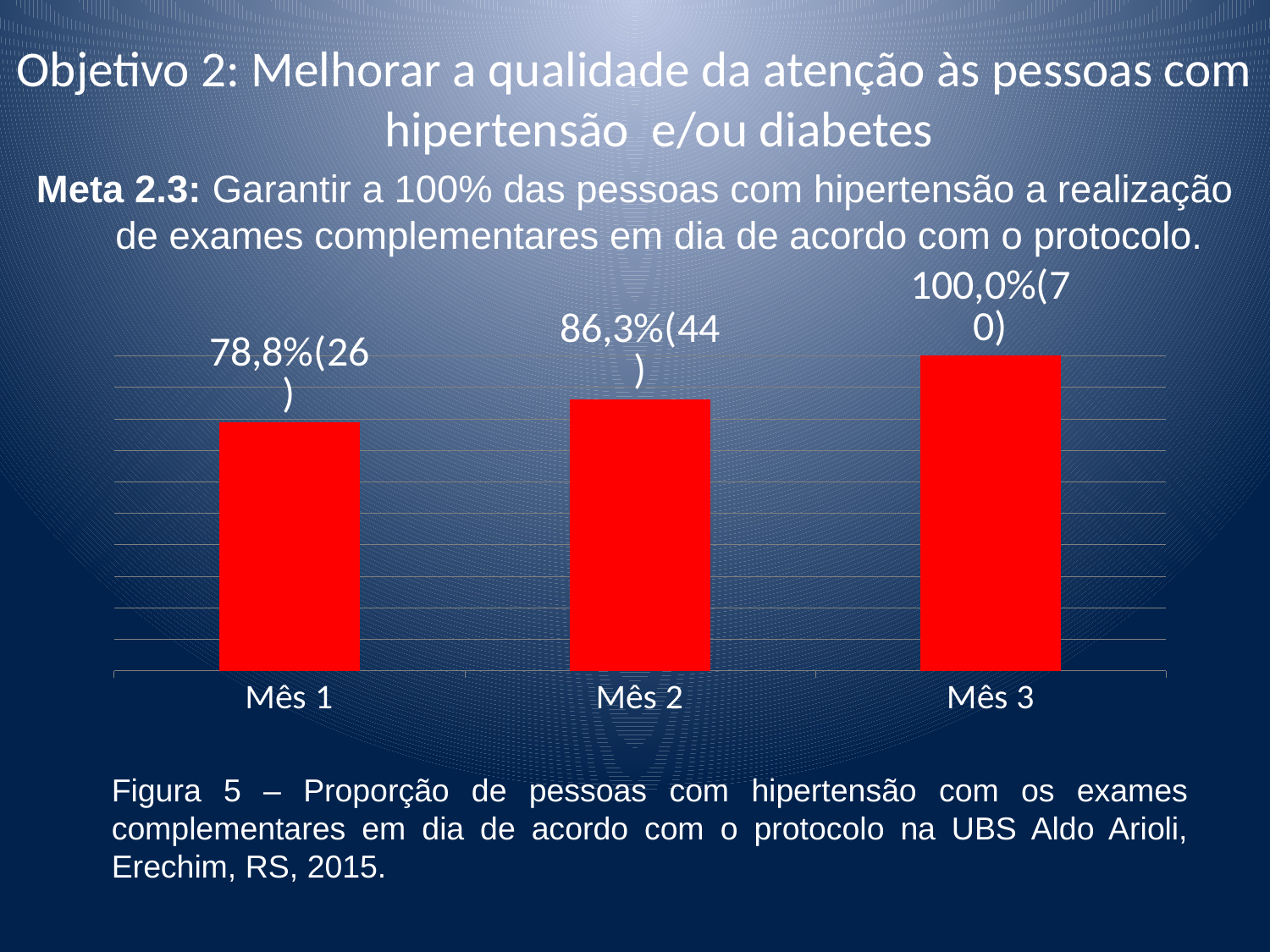
What kind of chart is shown on the slide? Bar chart What is the difference in percentage points between Mês 2 and Mês 1? 7,5 How many more people are counted in Mês 3 than in Mês 1? 44 Which month has the highest proportion? Mês 3 What is the value shown for Mês 1? 78,8%(26) Which is larger, the value for Mês 2 or the value for Mês 3? Mês 3 Which month has the lowest proportion? Mês 1 What is the value shown for Mês 3? 100,0%(70) What is the value shown for Mês 2? 86,3%(44) Do the values rise or fall from Mês 1 to Mês 3? Rise What is the difference in percentage points between Mês 3 and Mês 1? 21,2 How many months (categories) are shown in the chart? 3